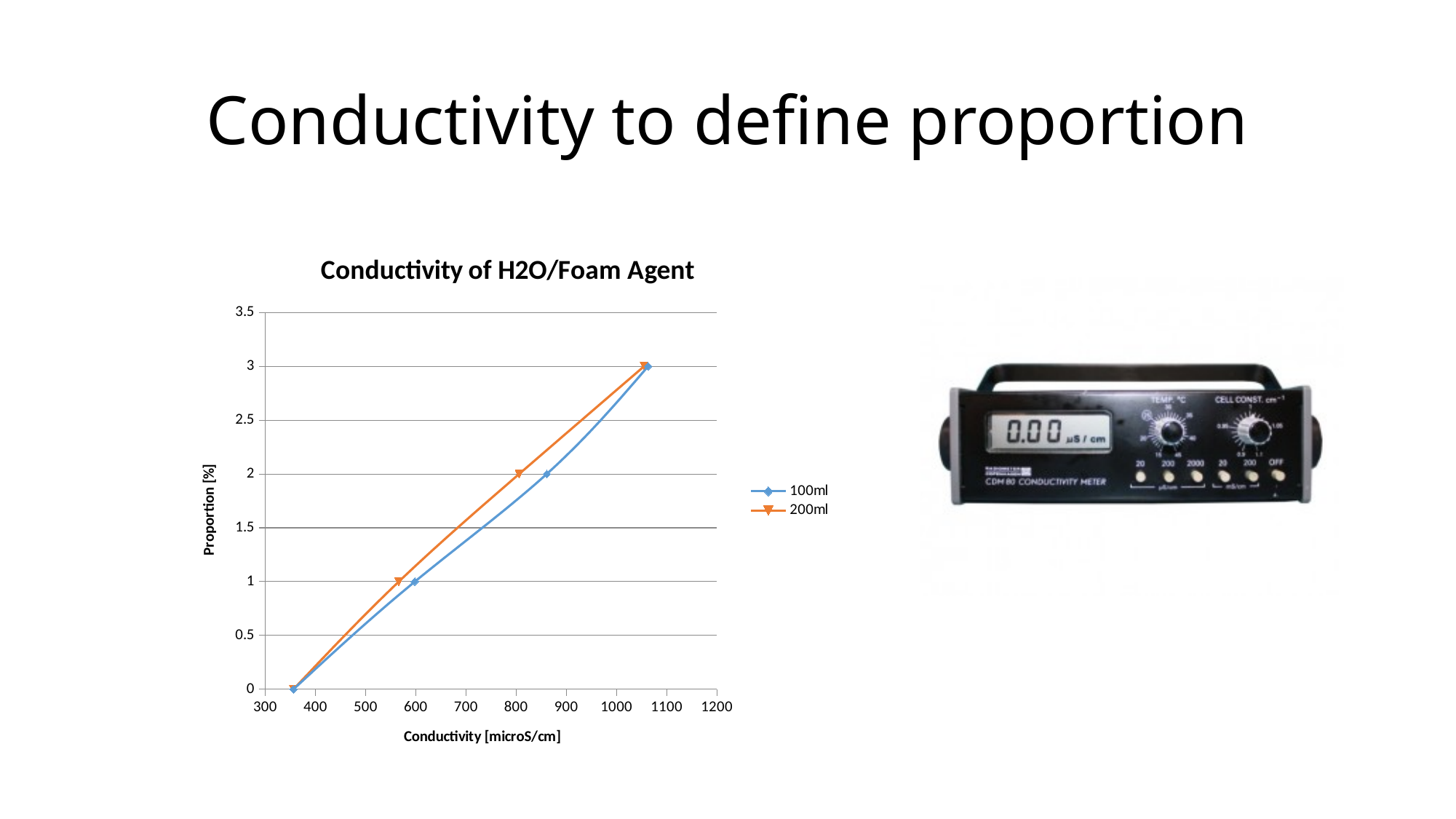
How many data points does the 100ml series have? 4 Is the conductivity of the 100ml series at a proportion of 2% greater or less than 800? greater What is the label of the x axis? Conductivity [microS/cm] How many series does the chart legend list? 2 What is the highest proportion value reached by the 200ml series? 3 At a proportion of 2%, which series has the lower conductivity, 100ml or 200ml? 200ml What are the two series named in the chart legend? 100ml and 200ml Is the conductivity of the 200ml series at a proportion of 1% greater or less than 600? less What is the lowest proportion value in the 100ml series? 0 What is the title of the chart? Conductivity of H2O/Foam Agent Does the proportion rise or fall as conductivity increases along the x axis? rise What kind of chart is shown on the slide? line chart